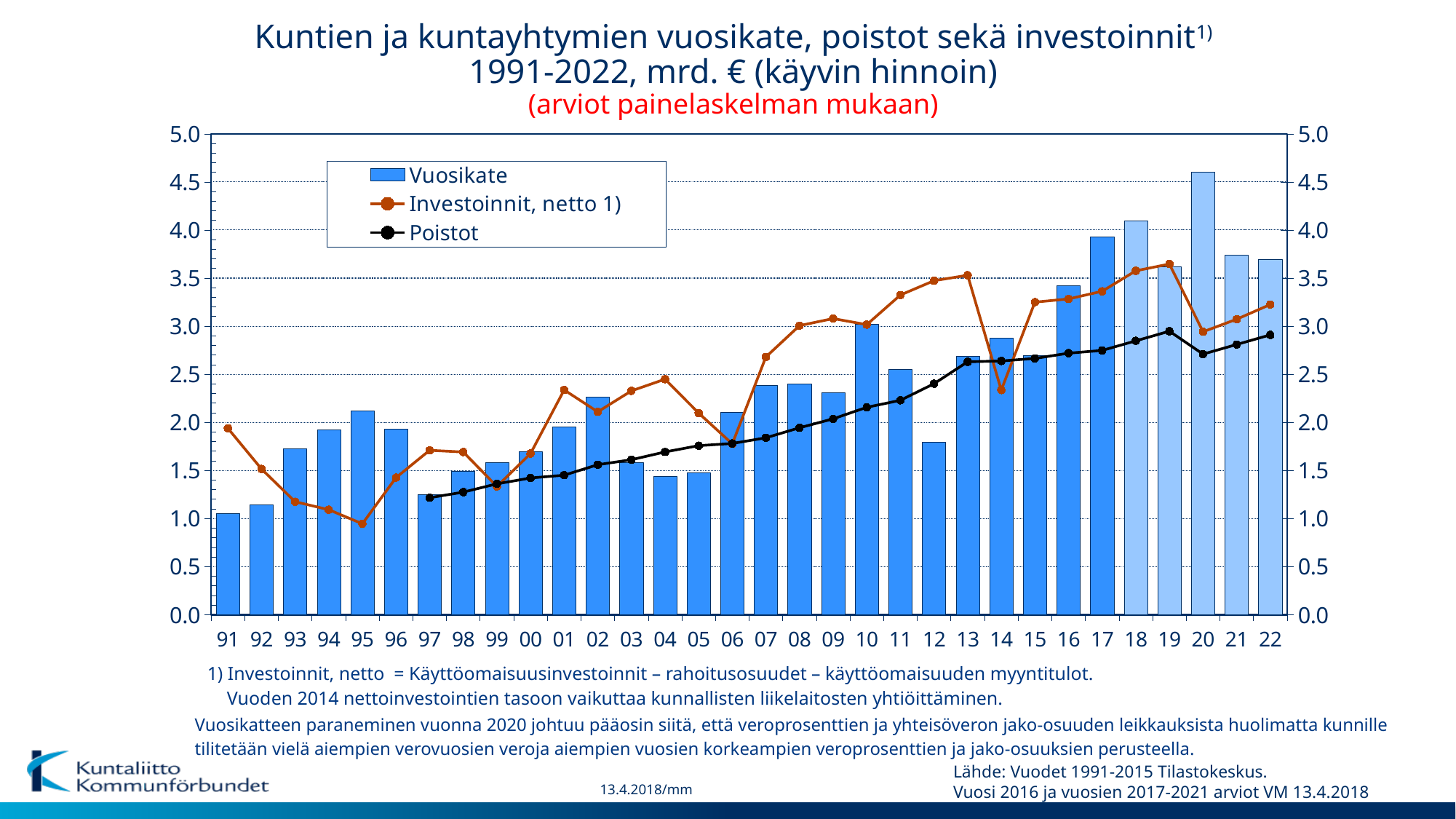
In which year is the Investoinnit, netto line at its lowest point? 95 Does the Poistot line generally rise or fall from 97 to 22? rise Which year has the larger Vuosikate bar, 10 or 11? 10 In which year is the Vuosikate bar lowest? 91 How many years are shown on the x axis? 32 Is the Investoinnit, netto value for 14 greater or less than 2.5? less In which year is the Vuosikate bar highest? 20 Is the Vuosikate value for 20 greater or less than 4.5? greater What kind of chart is shown on the slide? A combined bar and line chart Is the Vuosikate value for 12 greater or less than 2.0? less How many series does the legend list? 3 Which series is drawn as a black line with dot markers? Poistot